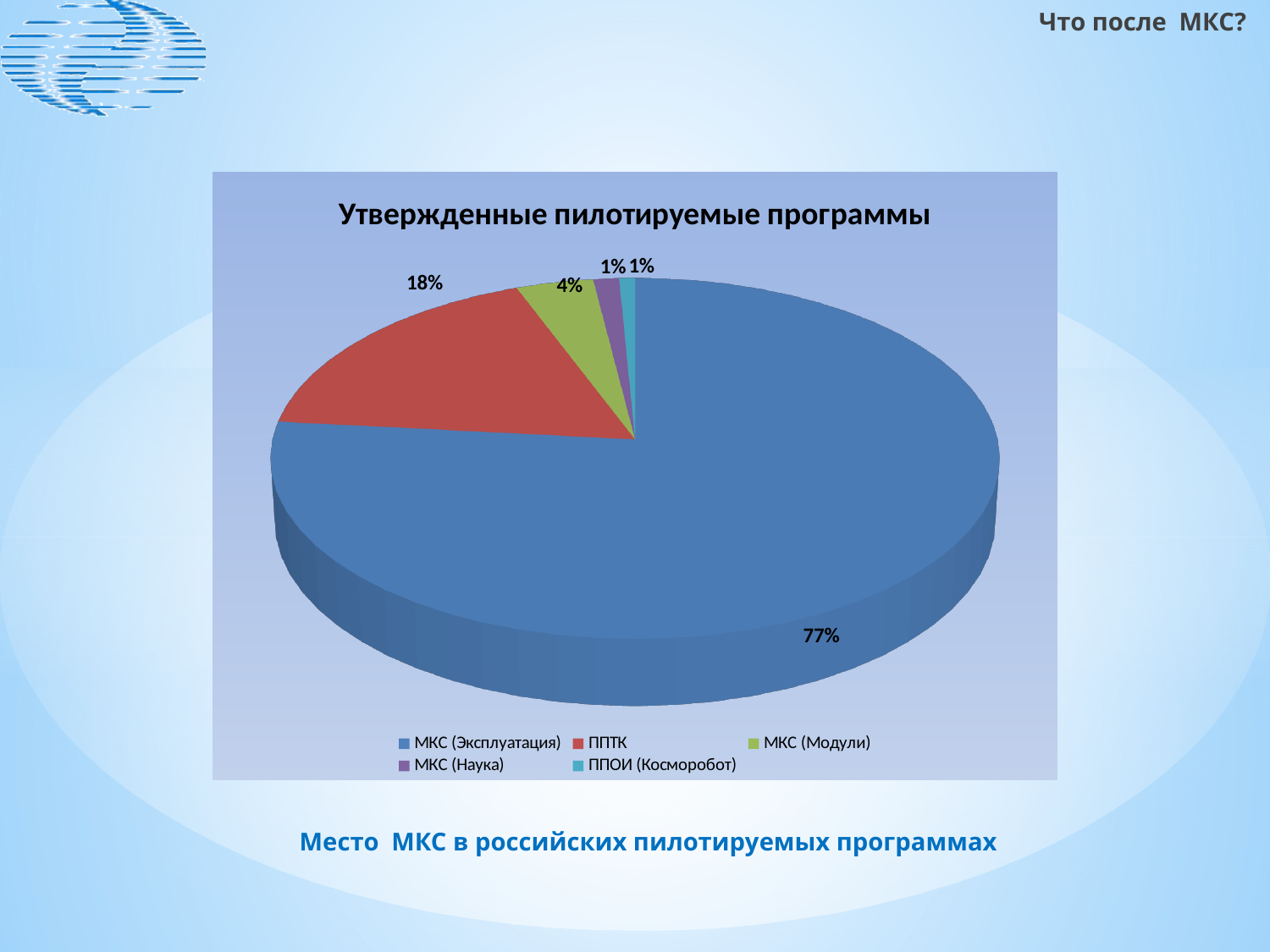
What share of the pie does МКС (Наука) take? 1% What share of the pie does МКС (Модули) take? 4% What share of the pie does МКС (Эксплуатация) take? 77% How many categories does the legend list? 5 What type of chart is shown on the slide? pie chart Which category has the largest slice of the pie? МКС (Эксплуатация) Which is larger, the share for ППТК or the share for МКС (Модули)? ППТК What is the title of the chart? Утвержденные пилотируемые программы What colour is the slice for ППТК? red What is the difference in percentage points between МКС (Эксплуатация) and ППТК? 59